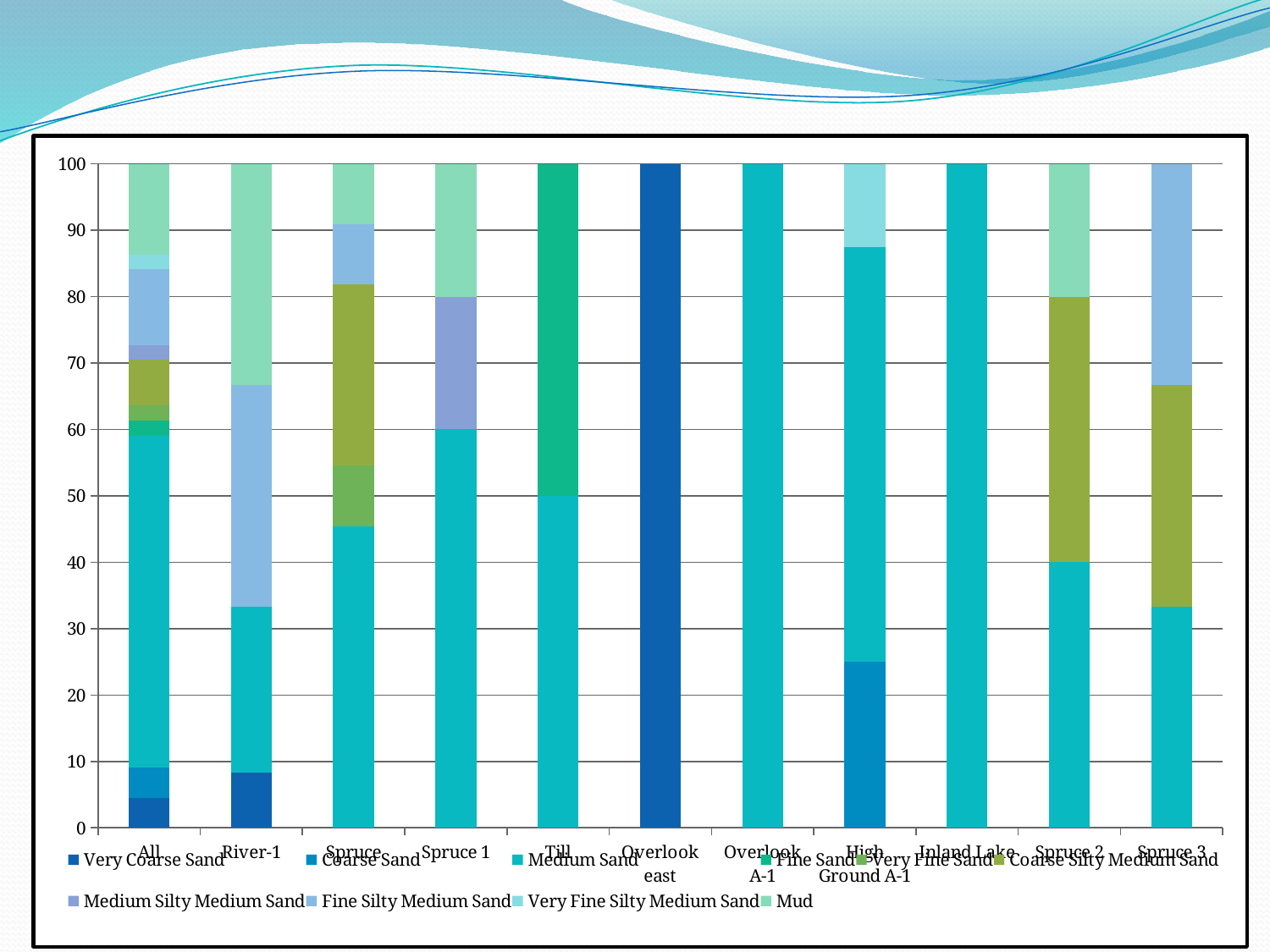
Is the top of the Medium Sand segment for Spruce 3 greater or less than 40? less What kind of chart is shown on the slide? stacked bar chart What is the total height of the stacked bar for Till? 100 Which category's bar consists entirely of Very Coarse Sand? Overlook east Is the Coarse Sand value for High Ground A-1 greater or less than 20? greater How many series does the legend list? 10 How many categories are shown along the x axis? 11 Which series is shown in dark blue at the bottom of the stacks? Very Coarse Sand Is the Medium Sand segment larger for Spruce 2 or for Spruce 3? Spruce 2 Is the Mud segment larger for River-1 or for All? River-1 Is the top of the Medium Sand segment for All greater or less than 50? greater